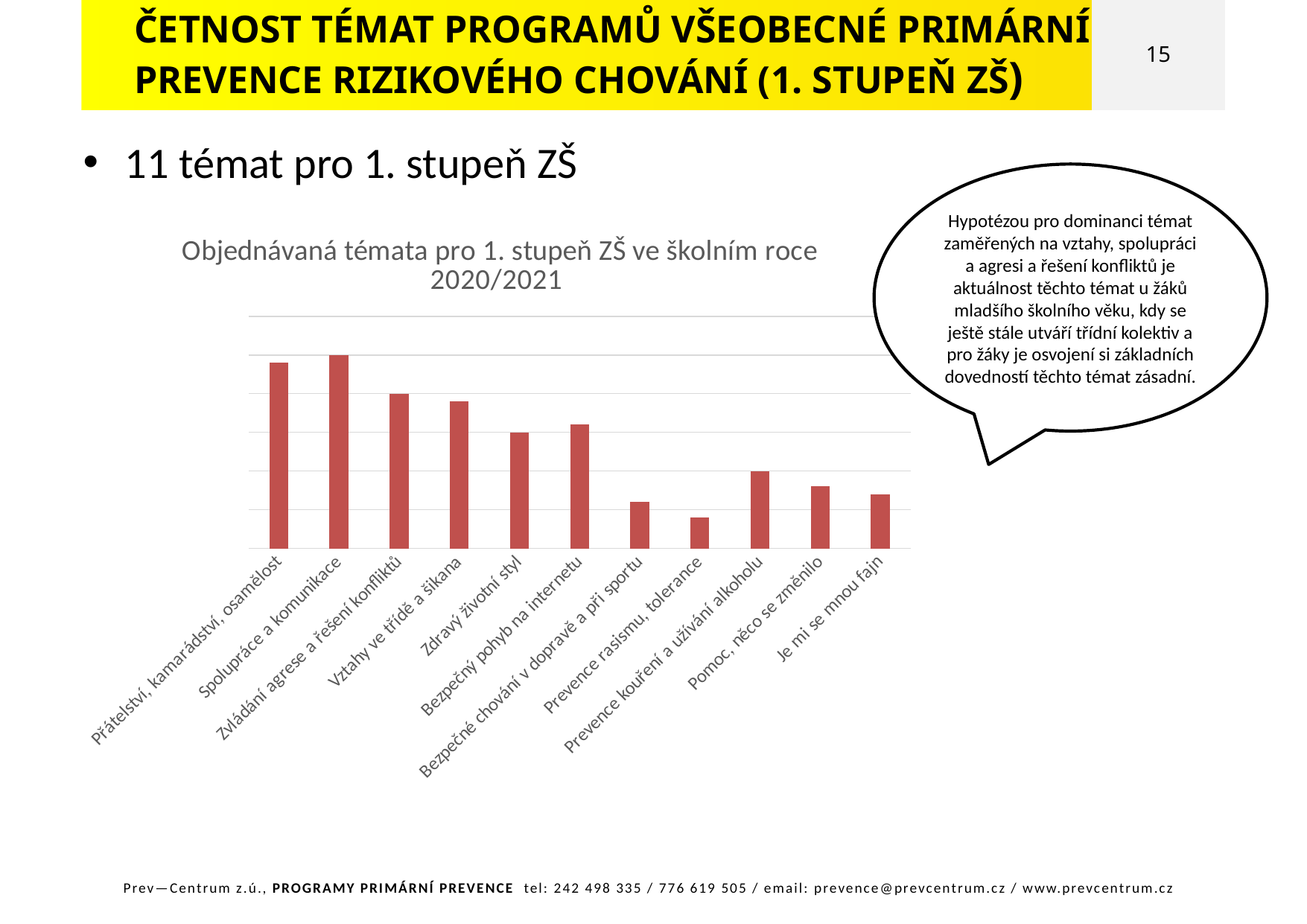
Which topic has the lowest bar in the chart? Prevence rasismu, tolerance How many categories (topics) are plotted in the chart? 11 Which is larger: the value for "Prevence kouření a užívání alkoholu" or for "Pomoc, něco se změnilo"? Prevence kouření a užívání alkoholu What colour are the bars in the chart? Red Which is larger: the value for "Bezpečný pohyb na internetu" or for "Bezpečné chování v dopravě a při sportu"? Bezpečný pohyb na internetu What kind of chart is shown on the slide? Bar chart What is the title of the chart? Objednávaná témata pro 1. stupeň ZŠ ve školním roce 2020/2021 Which is larger: the value for "Je mi se mnou fajn" or for "Prevence rasismu, tolerance"? Je mi se mnou fajn